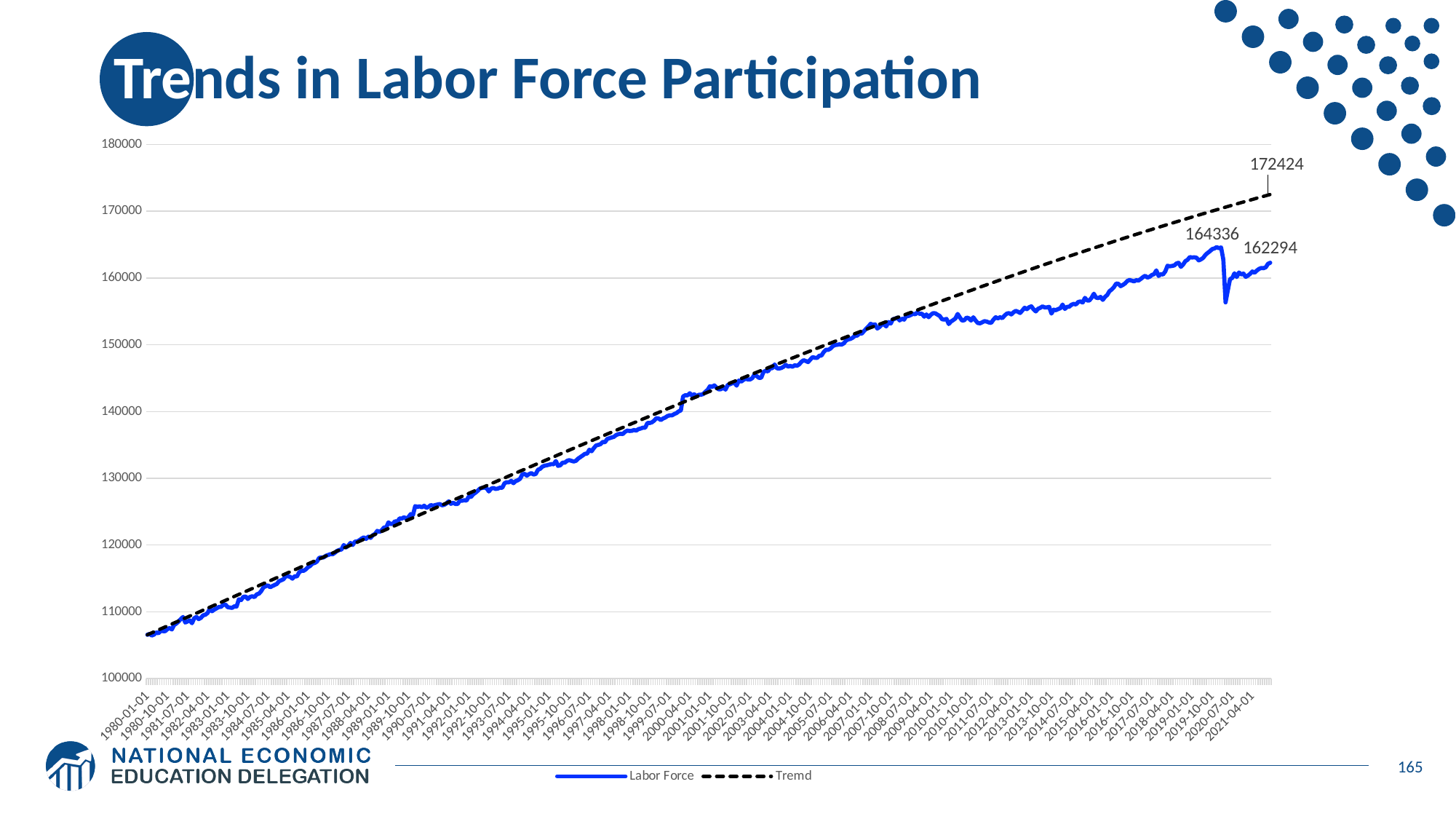
How much higher is the labeled Labor Force peak of 164336 than the final Labor Force value of 162294? 2042 What is the final labeled value of the Tremd (trend) line? 172424 What are the two legend entries on the chart? Labor Force and Tremd What is the difference between the final trend value (172424) and the final Labor Force value (162294)? 10130 At the end of the chart, which is larger: the Tremd line or the Labor Force line? Tremd What is the final labeled value of the Labor Force line? 162294 Is the Labor Force value at 2010-01-01 greater or less than 160000? less Does the Labor Force line generally rise or fall from 1980 to 2021? Rise Is the Labor Force value at 1980-01-01 greater or less than 110000? less What is the labeled peak value of the Labor Force line just before the sharp drop in 2020? 164336 How many series does the legend list? 2 What kind of chart is shown on the slide? Line chart